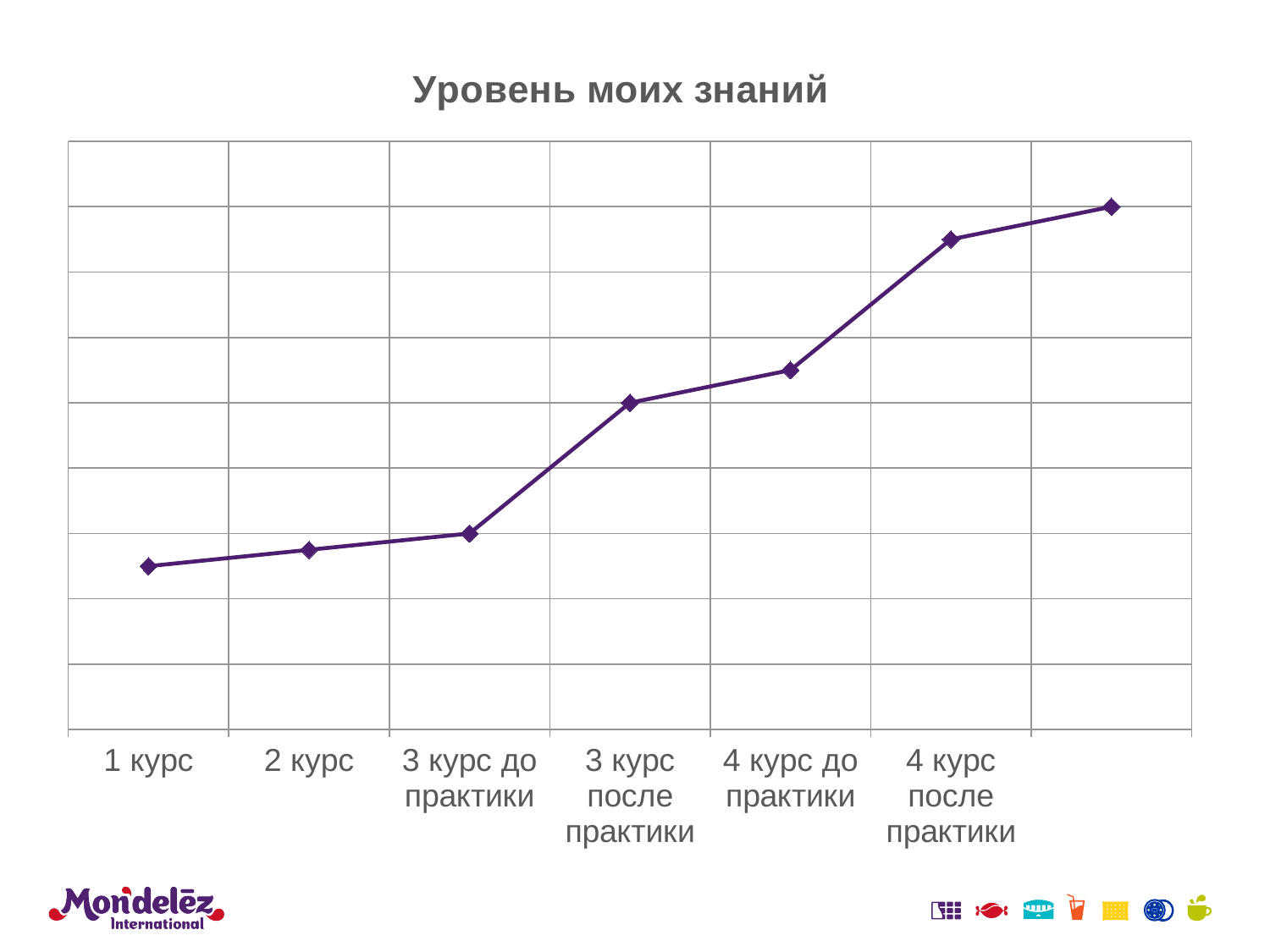
What is the title of the chart? Уровень моих знаний What is the label of the first category on the x axis? 1 курс How many data points are plotted on the line? 7 Which is larger, the value for 3 курс до практики or the value for 3 курс после практики? 3 курс после практики Which is larger, the value for 4 курс до практики or the value for 4 курс после практики? 4 курс после практики Do the values rise or fall from left to right along the x axis? rise What kind of chart is shown on the slide? line chart Which category has the lowest value? 1 курс Which is larger, the value for 2 курс or the value for 4 курс до практики? 4 курс до практики